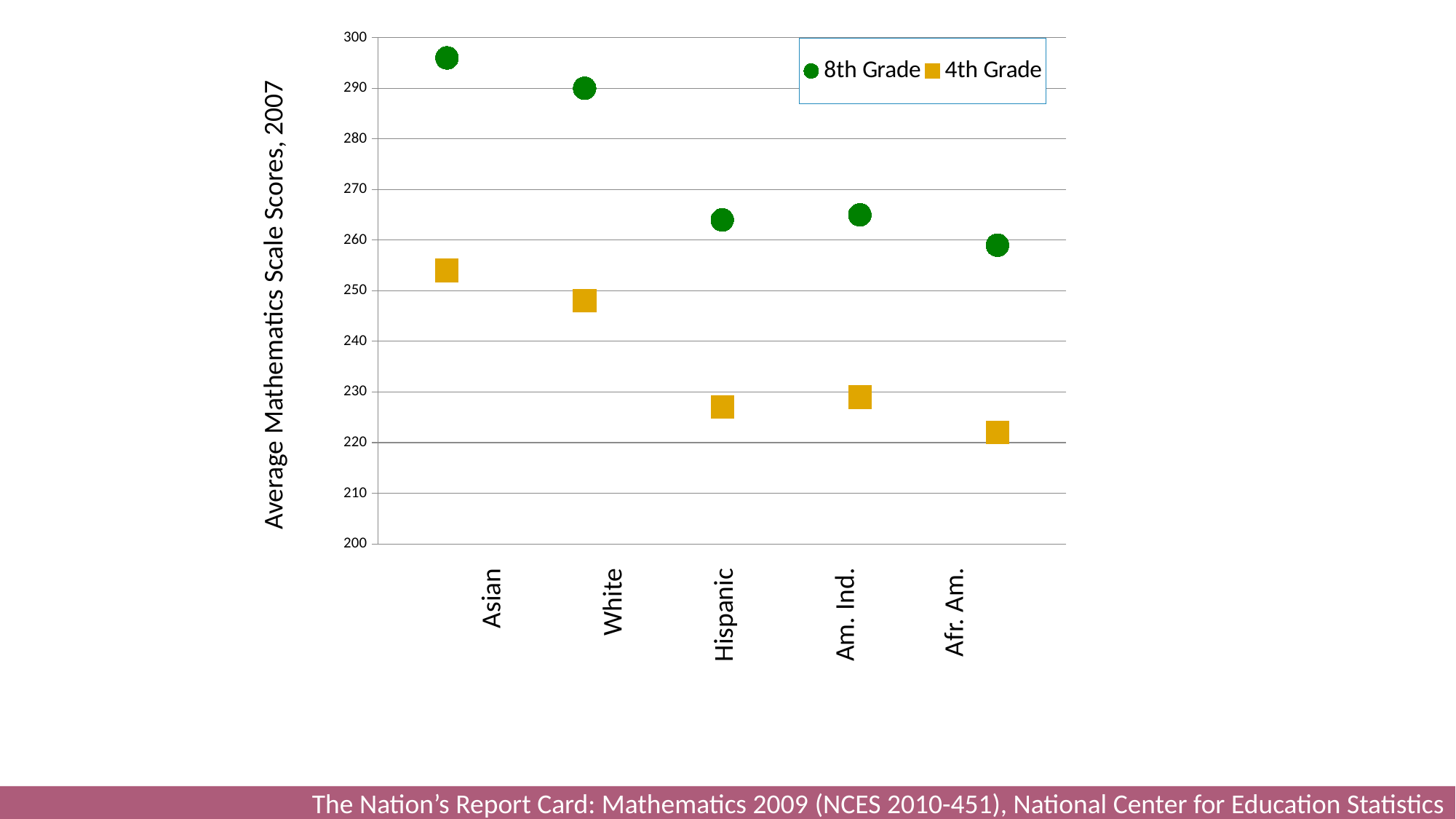
Is the 8th Grade value for Am. Ind. greater or less than 270? less Which category has the lowest 4th Grade score? Afr. Am. Which is larger, the 8th Grade score for Asian or for White? Asian How many categories are shown on the x axis? 5 What is the label on the vertical axis? Average Mathematics Scale Scores, 2007 Which category has the highest 8th Grade score? Asian What kind of chart is shown on the slide? Scatter (dot) chart Is the 4th Grade value for Hispanic greater or less than 230? less Do the 4th Grade scores generally rise or fall from Asian to Afr. Am. along the x axis? fall Is the 8th Grade value for Asian greater or less than 290? greater Which category has the lowest 8th Grade score? Afr. Am. How many series does the legend list? 2